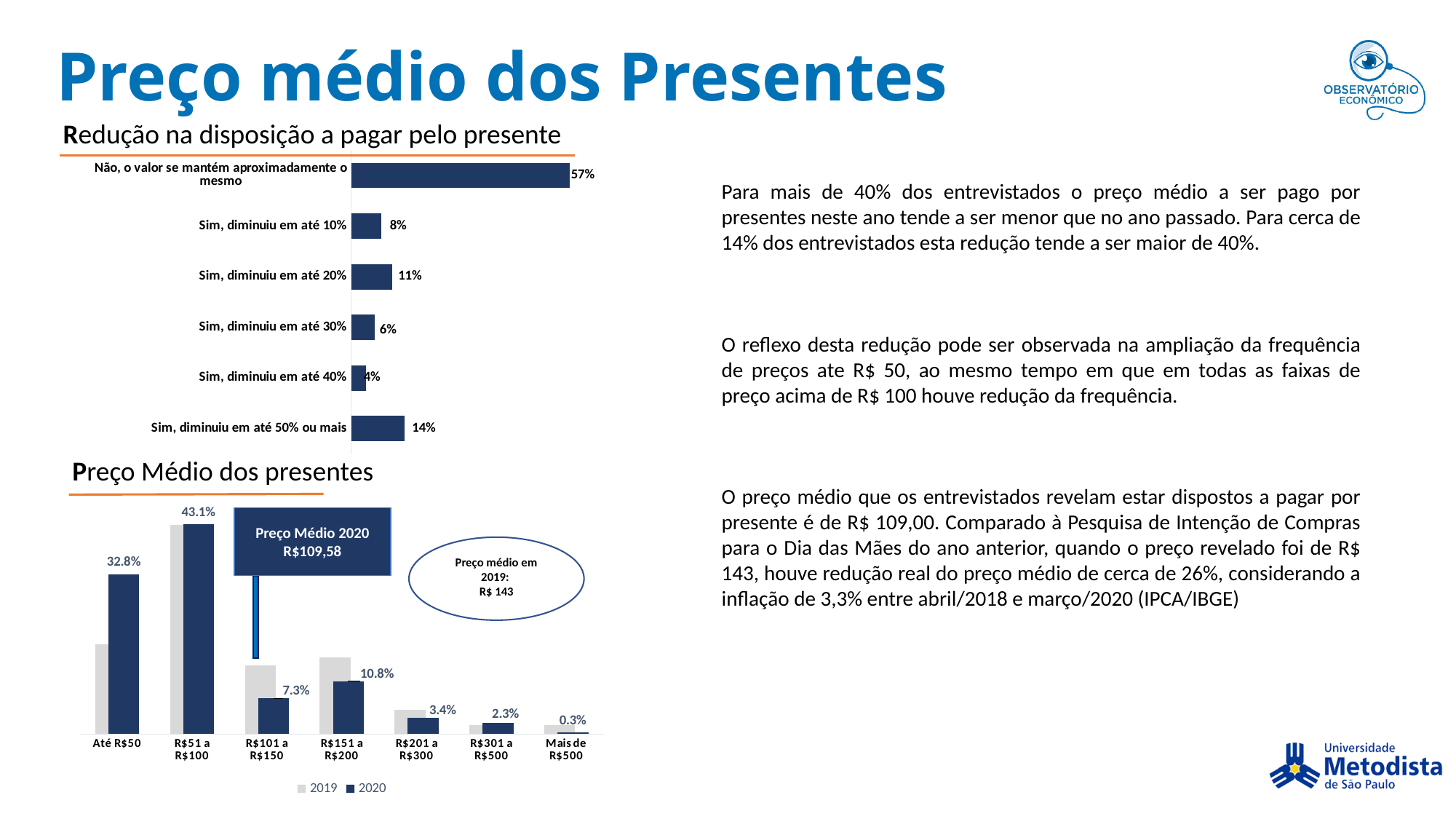
In the 'Preço Médio dos presentes' chart, what is the difference between the 2020 values for 'R$151 a R$200' and 'R$101 a R$150'? 3.5% In the 'Redução na disposição a pagar pelo presente' chart, which category has the lowest value? Sim, diminuiu em até 40% In the 'Preço Médio dos presentes' chart, how many series does the legend list? 2 In the 'Redução na disposição a pagar pelo presente' chart, how many categories are shown? 6 In the 'Redução na disposição a pagar pelo presente' chart, what is the value for 'Não, o valor se mantém aproximadamente o mesmo'? 57% In the 'Preço Médio dos presentes' chart, for 'Até R$50', is the 2020 bar larger or smaller than the 2019 bar? Larger In the 'Preço Médio dos presentes' chart, which price range has the highest 2020 value? R$51 a R$100 In the 'Redução na disposição a pagar pelo presente' chart, what is the difference between 'Sim, diminuiu em até 20%' and 'Sim, diminuiu em até 10%'? 3% In the 'Preço Médio dos presentes' chart, what is the 2020 value for 'R$101 a R$150'? 7.3% In the 'Preço Médio dos presentes' chart, what is the 2020 value for 'R$51 a R$100'? 43.1% What type of chart is the 'Redução na disposição a pagar pelo presente' chart? Bar chart In the 'Redução na disposição a pagar pelo presente' chart, what is the value for 'Sim, diminuiu em até 50% ou mais'? 14%